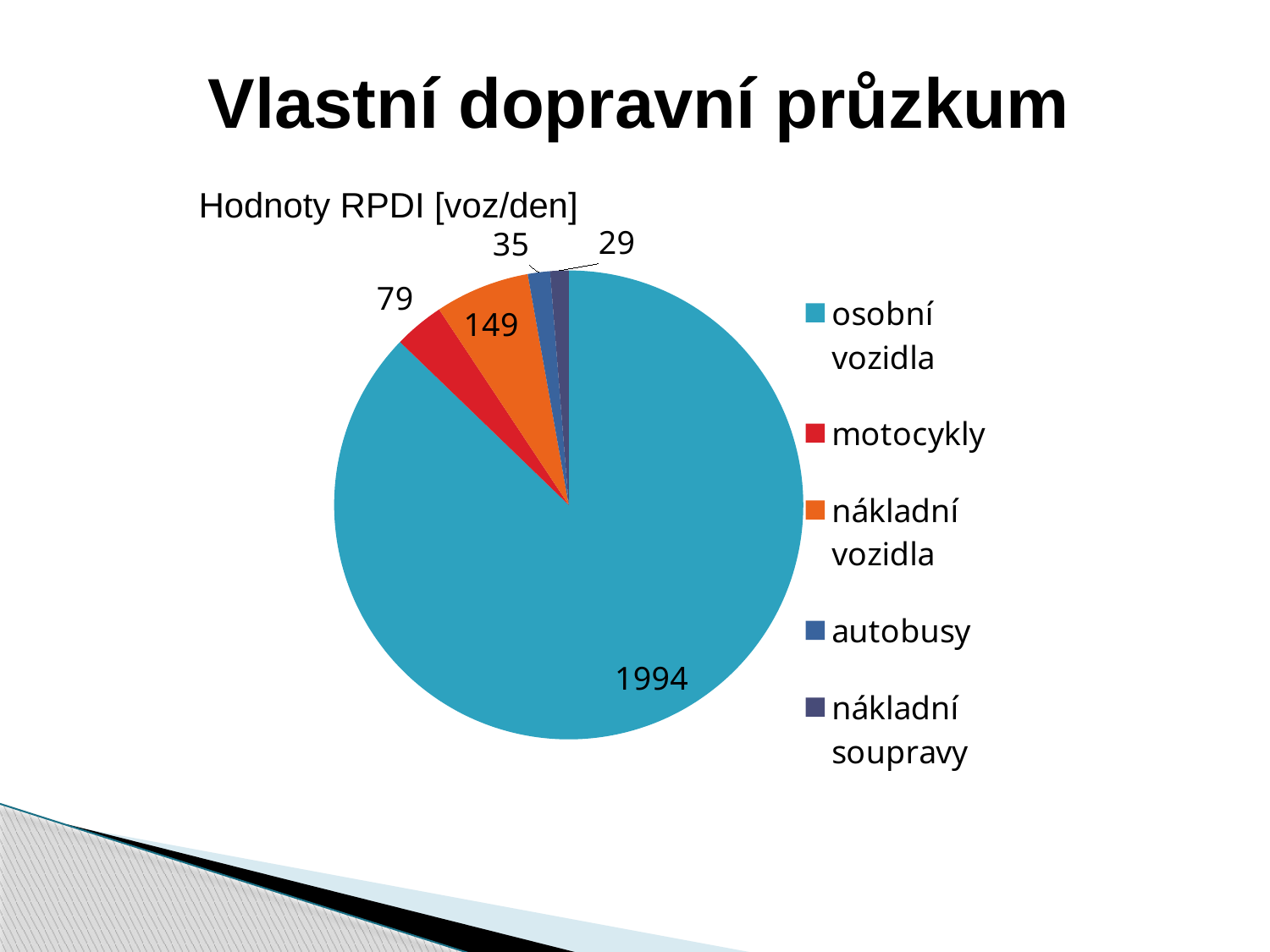
What is the difference between the values for nákladní vozidla and motocykly? 70 What is the value for osobní vozidla in the pie chart? 1994 Which category has the smallest slice in the pie chart? nákladní soupravy What is the title of the chart? Hodnoty RPDI [voz/den] What is the value for nákladní soupravy in the pie chart? 29 What is the value for motocykly in the pie chart? 79 How many categories does the pie chart show? 5 Which is larger, the value for autobusy or the value for nákladní soupravy? autobusy What is the value for autobusy in the pie chart? 35 What kind of chart is shown on the slide? pie chart What is the value for nákladní vozidla in the pie chart? 149 Which category has the largest slice in the pie chart? osobní vozidla